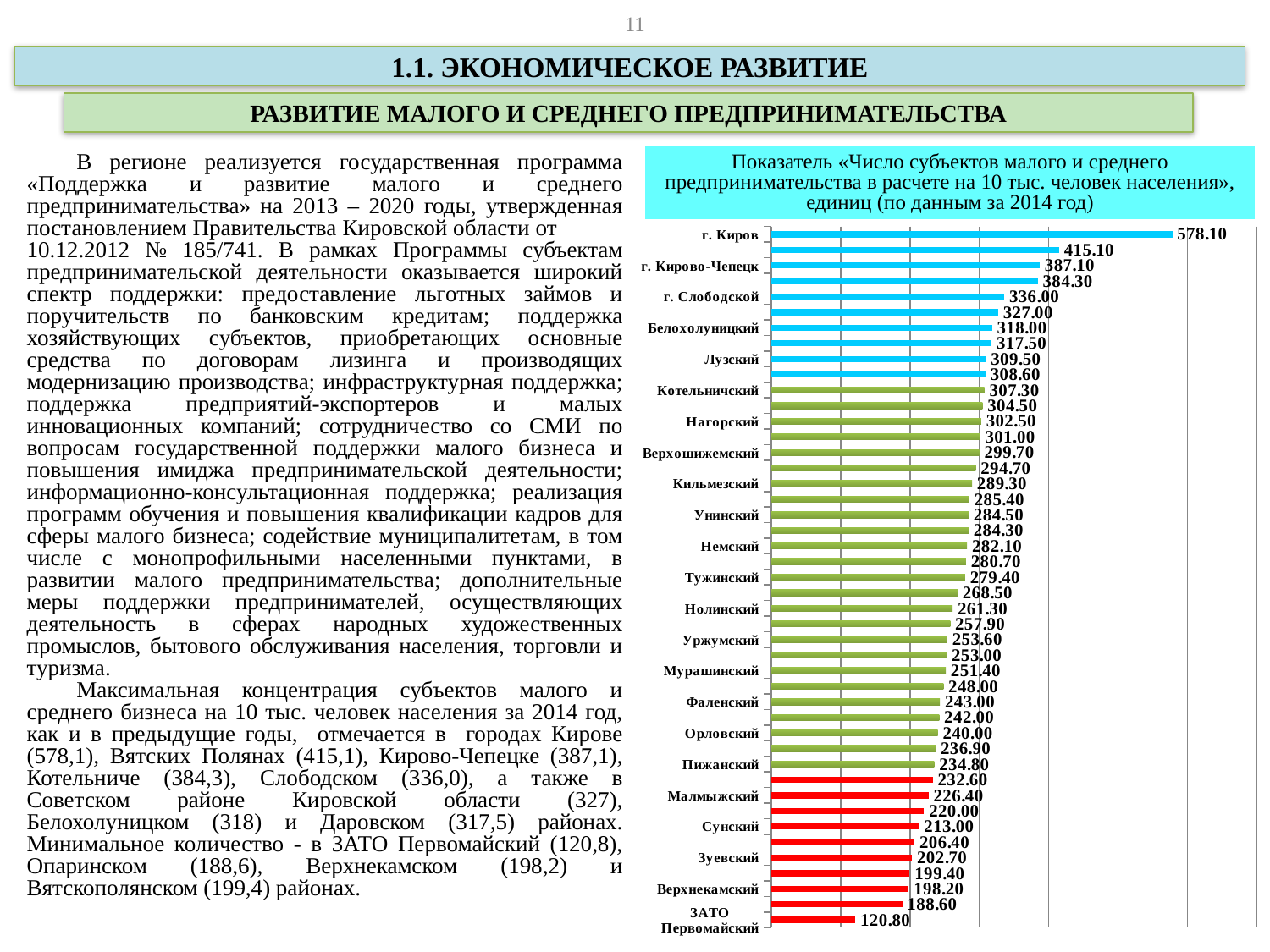
What kind of chart is shown on the slide? Bar chart What is the value for Верхнекамский? 198.20 What is the value for ЗАТО Первомайский? 120.80 What is the value for г. Киров? 578.10 What is the value for г. Слободской? 336.00 What is the difference between the values for Сунский and Зуевский? 10.30 Which category has the lowest value? ЗАТО Первомайский What is the difference between the values for г. Киров and г. Кирово-Чепецк? 191.00 Which category has the highest value? г. Киров What colour is the bar for г. Киров? Blue Which is larger, the value for Нолинский or the value for Уржумский? Нолинский What is the value for Белохолуницкий? 318.00